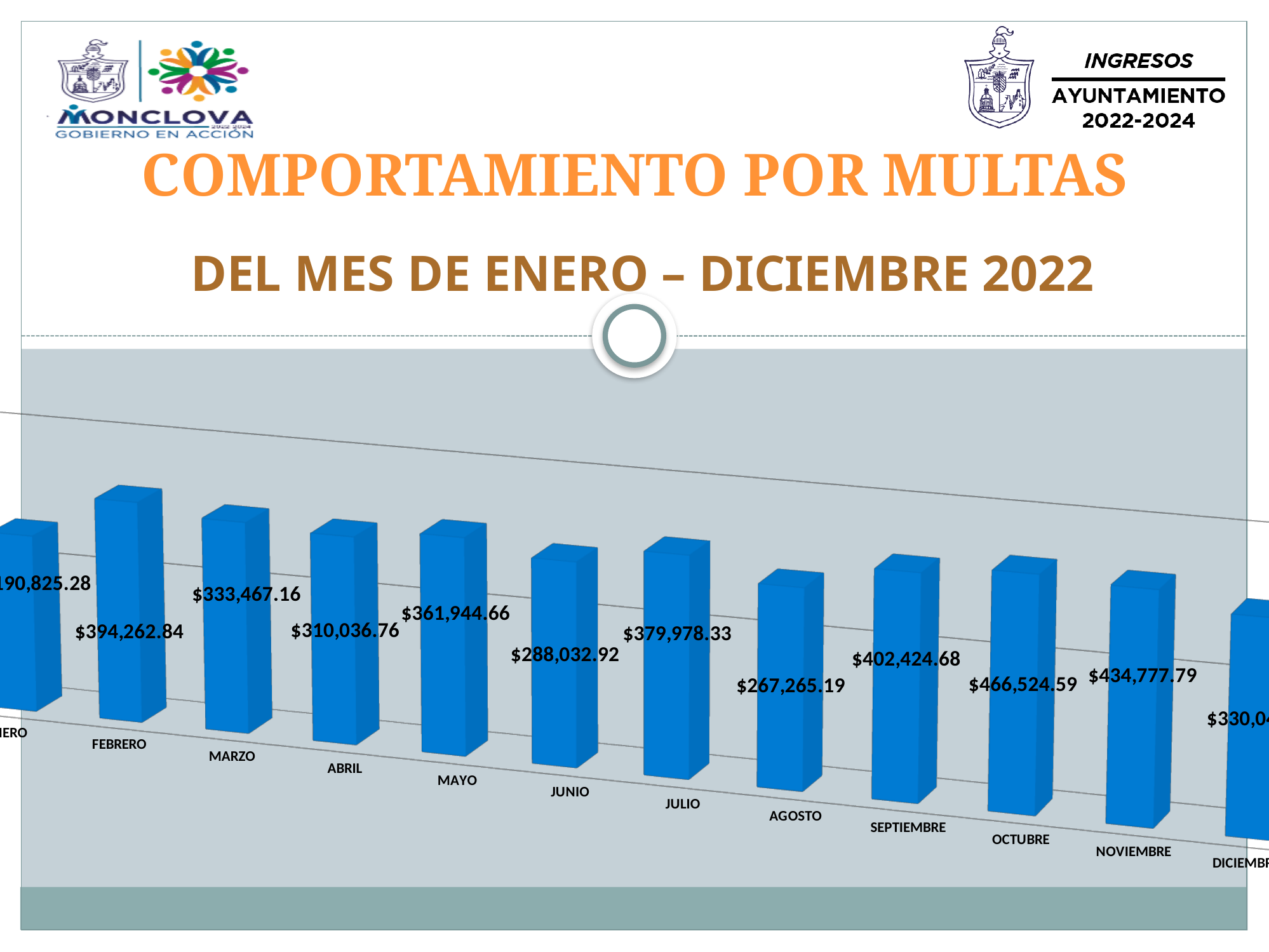
What is the value for NOVIEMBRE? $434,777.79 What is the value for MARZO? $333,467.16 What is the value for JUNIO? $288,032.92 Which is larger, the value for OCTUBRE or the value for NOVIEMBRE? OCTUBRE What is the difference between the values for OCTUBRE and NOVIEMBRE? $31,746.80 How many months are shown on the chart? 12 What is the value for FEBRERO? $394,262.84 What is the difference between the values for FEBRERO and MARZO? $60,795.68 Which is larger, the value for JULIO or the value for AGOSTO? JULIO What is the value for AGOSTO? $267,265.19 What kind of chart is shown on the slide? Bar chart What is the value for OCTUBRE? $466,524.59